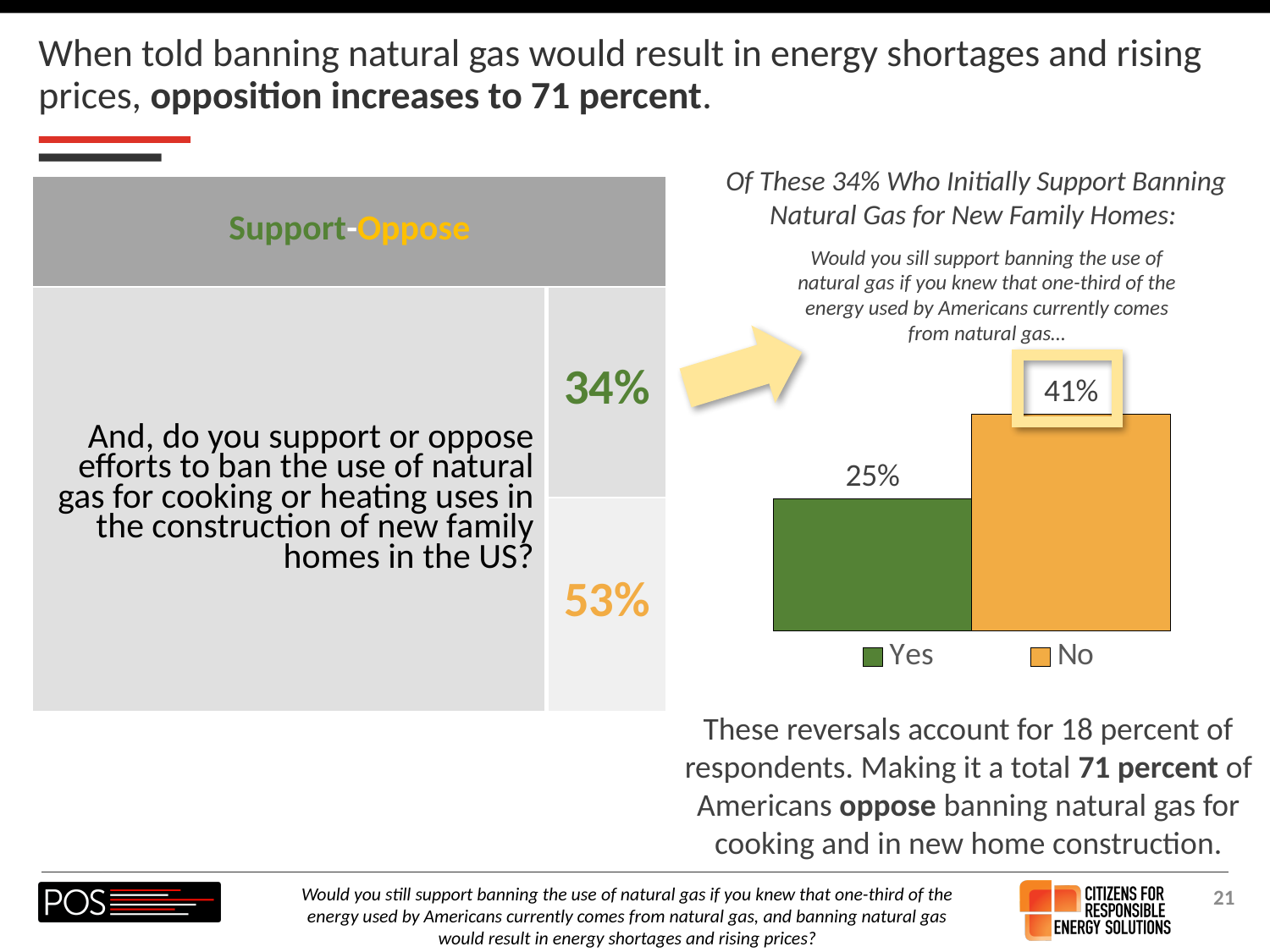
What is the difference between the No and Yes values in the bar chart? 16% How many bars are shown in the bar chart? 2 Which category has the higher value in the bar chart, Yes or No? No How many entries does the legend of the bar chart list? 2 What is the value for Yes in the bar chart? 25% What colour is the Yes bar in the bar chart? green What colour is the No bar in the bar chart? orange Is the value for Yes larger or smaller than the value for No in the bar chart? smaller What type of chart is shown on the right side of the slide? bar chart What is the value for No in the bar chart? 41% Which category has the lower value in the bar chart? Yes